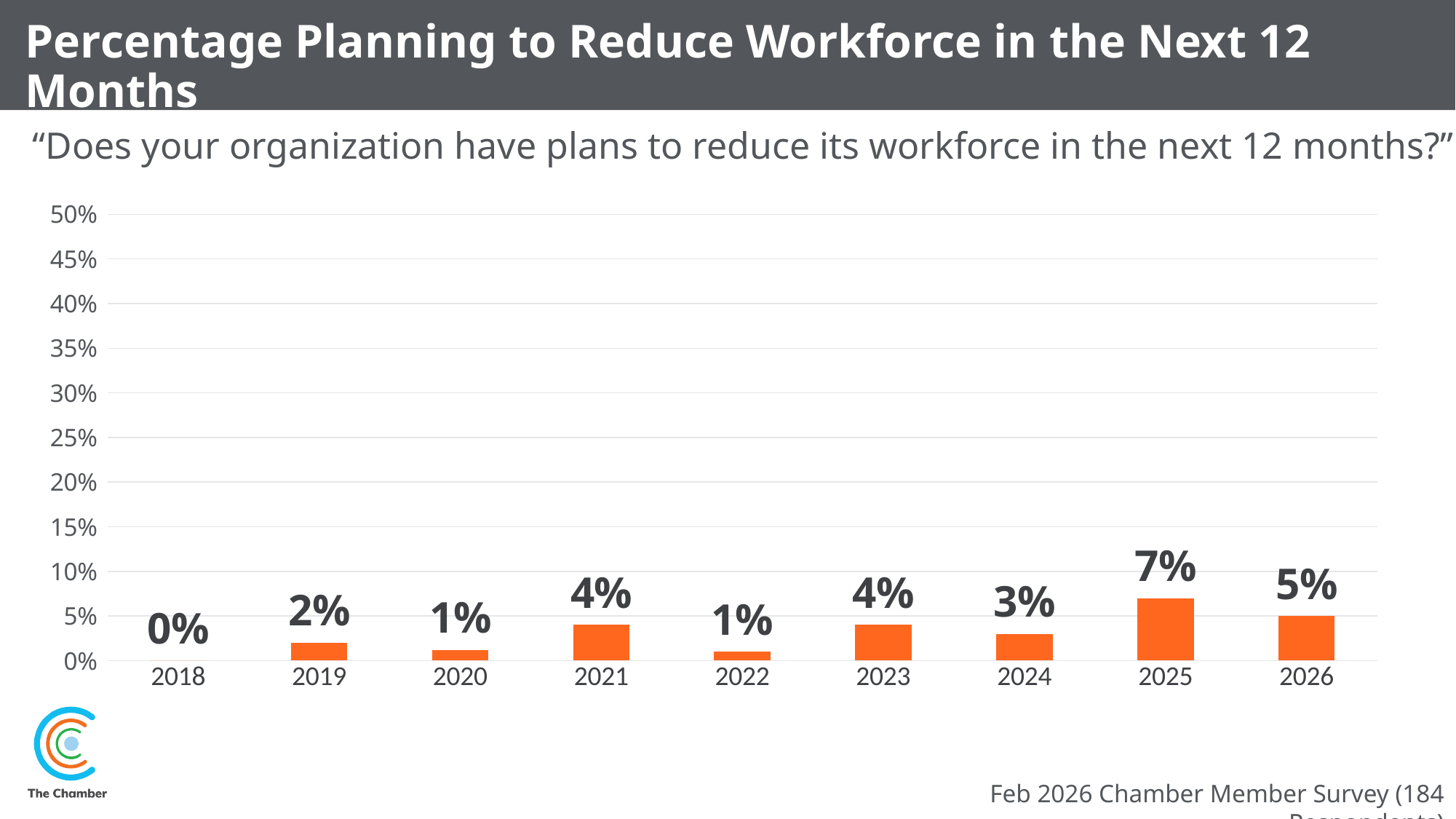
Which year has the highest percentage planning to reduce workforce? 2025 What is the difference between the 2025 value and the 2026 value? 2% What kind of chart is shown on the slide? Bar chart What is the value shown for 2022? 1% What is the highest value labelled on the y axis? 50% What is the value shown for 2026? 5% Which year has the lowest percentage planning to reduce workforce? 2018 Is the value for 2025 greater or less than 10%? less Which year has a larger value, 2021 or 2024? 2021 How many years are shown on the x axis? 9 What percentage of organizations planned to reduce their workforce in 2025? 7% What is the value shown for 2018? 0%